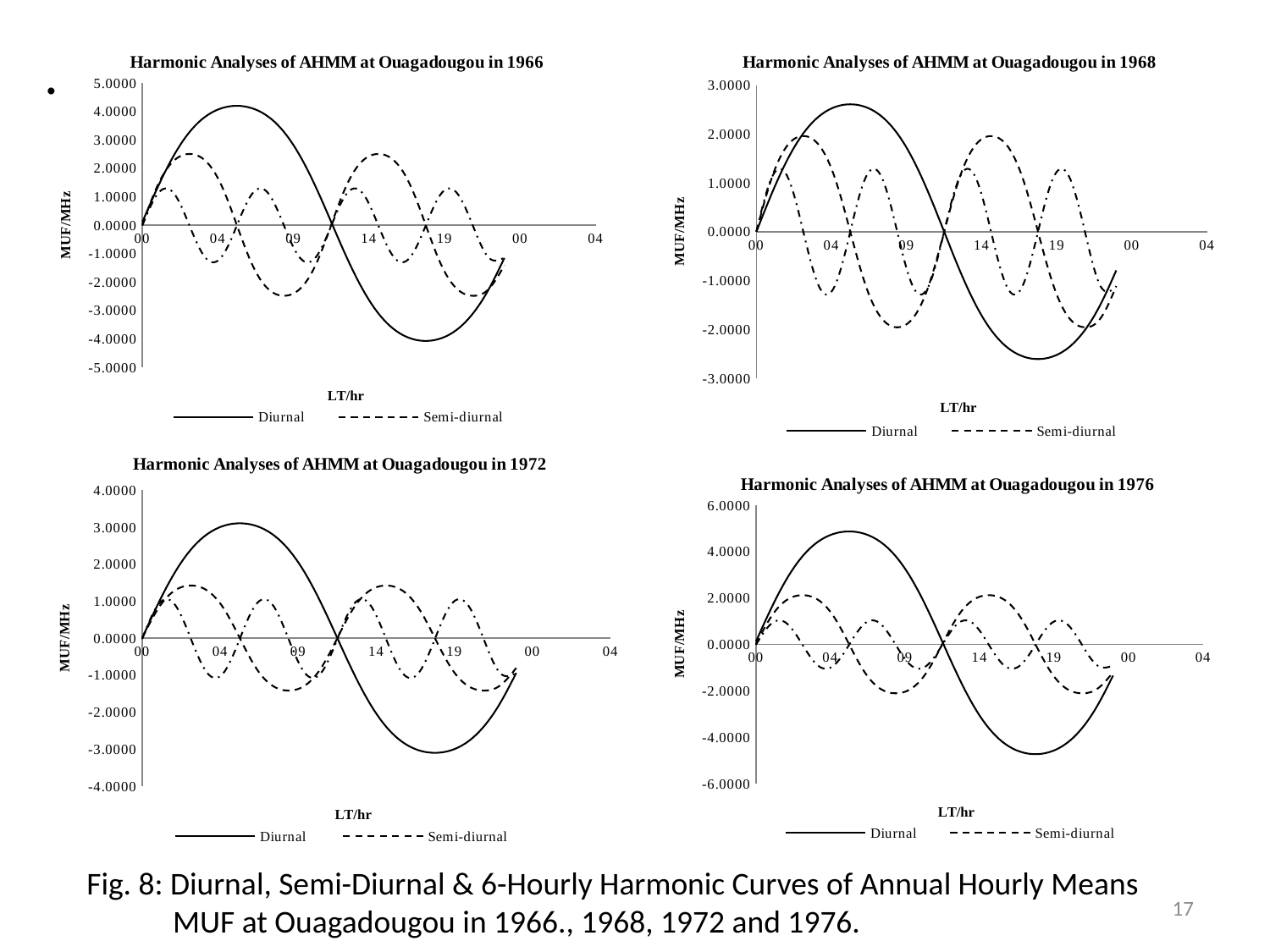
On the 'Harmonic Analyses of AHMM at Ouagadougou in 1968' chart, is the peak value of the Diurnal curve greater or less than 2.0000? greater What is the x-axis label on the 'Harmonic Analyses of AHMM at Ouagadougou in 1972' chart? LT/hr On the 'Harmonic Analyses of AHMM at Ouagadougou in 1976' chart, is the peak value of the Diurnal curve greater or less than 4.0000? greater On the 'Harmonic Analyses of AHMM at Ouagadougou in 1972' chart, is the peak value of the Semi-diurnal curve greater or less than 1.0000? greater What kind of chart is 'Harmonic Analyses of AHMM at Ouagadougou in 1966'? Line chart What is the y-axis label on the 'Harmonic Analyses of AHMM at Ouagadougou in 1976' chart? MUF/MHz How many series does the legend list on the 'Harmonic Analyses of AHMM at Ouagadougou in 1966' chart? 2 On the 'Harmonic Analyses of AHMM at Ouagadougou in 1968' chart, does the Diurnal curve rise or fall between 09 and 14 LT/hr? Falls On the 'Harmonic Analyses of AHMM at Ouagadougou in 1966' chart, which curve reaches a higher peak, Diurnal or Semi-diurnal? Diurnal